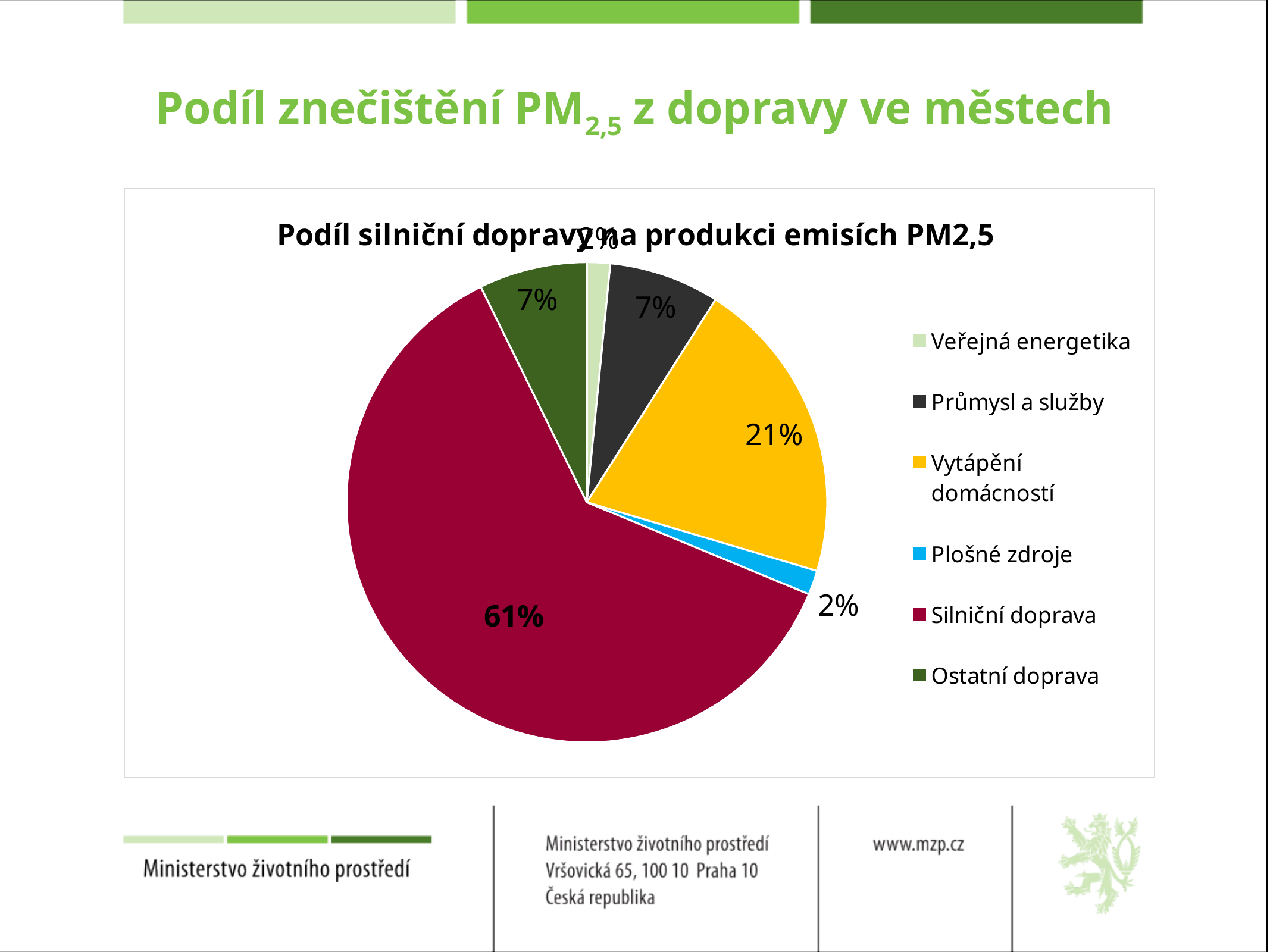
Which category has the largest slice of the pie chart? Silniční doprava By how many percentage points does the share of Silniční doprava exceed that of Vytápění domácností? 40 percentage points What colour is the slice for Silniční doprava? Dark red What percentage is shown for Průmysl a služby? 7% How many categories are listed in the pie chart's legend? 6 What is the title of the chart? Podíl silniční dopravy na produkci emisích PM2,5 What percentage is shown for Ostatní doprava? 7% What share of PM2,5 emissions does Silniční doprava account for in the pie chart? 61% What type of chart is shown on the slide? Pie chart Which is larger, the share for Vytápění domácností or for Průmysl a služby? Vytápění domácností What percentage is shown for Plošné zdroje? 2% What percentage is shown for Vytápění domácností? 21%